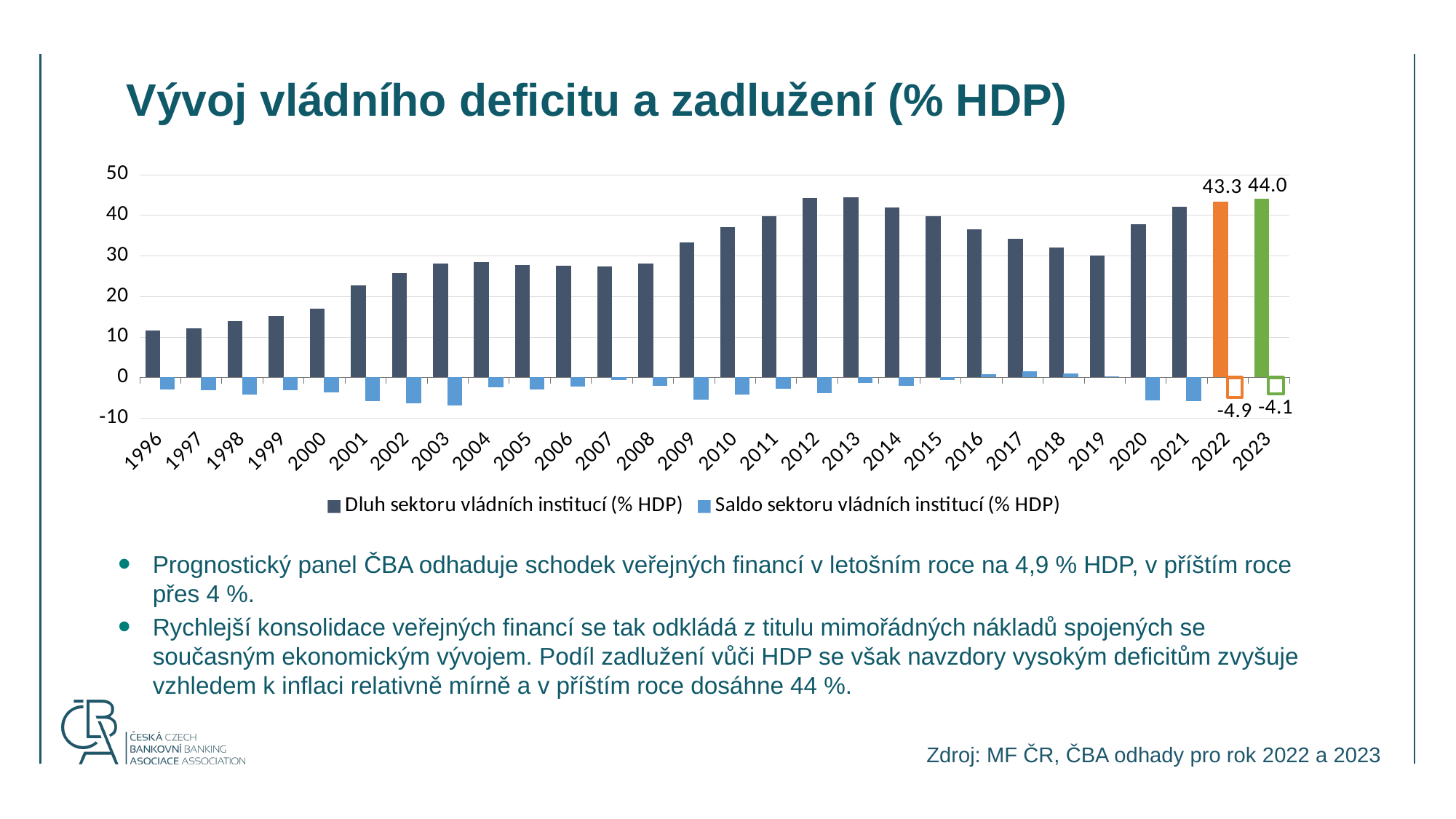
What is the value of Saldo sektoru vládních institucí (% HDP) for 2023? -4.1 Is the debt value for 1996 greater or less than 20? less How many years are shown on the x axis? 28 How many series does the legend list? 2 Is the debt value for 2012 greater or less than 40? greater What is the value of Dluh sektoru vládních institucí (% HDP) for 2022? 43.3 What is the value of Saldo sektoru vládních institucí (% HDP) for 2022? -4.9 Which year has the larger debt value, 2022 or 2023? 2023 What is the value of Dluh sektoru vládních institucí (% HDP) for 2023? 44.0 What kind of chart is shown on the slide? Bar chart By how much does the debt value for 2023 exceed the debt value for 2022? 0.7 Which year has the lowest debt value? 1996